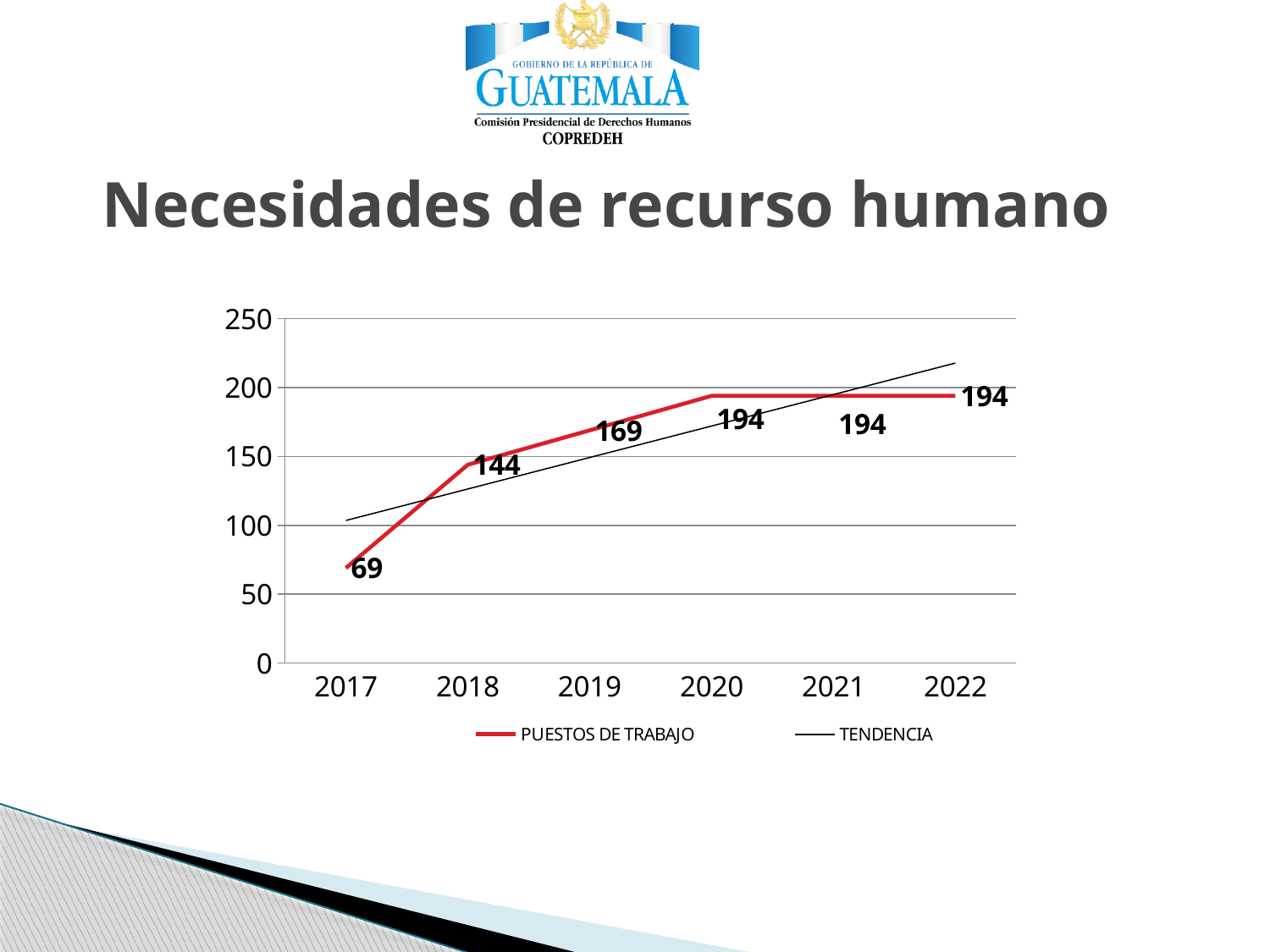
What is the value of PUESTOS DE TRABAJO for 2019? 169 Which is larger, the PUESTOS DE TRABAJO value for 2019 or for 2018? 2019 What kind of chart is shown on the slide? line chart How many years are shown on the x axis? 6 What is the value of PUESTOS DE TRABAJO for 2022? 194 What is the value of PUESTOS DE TRABAJO for 2018? 144 How many series does the legend list? 2 Which year has the lowest value for PUESTOS DE TRABAJO? 2017 What is the difference between the PUESTOS DE TRABAJO values for 2020 and 2019? 25 What is the difference between the PUESTOS DE TRABAJO values for 2018 and 2017? 75 What is the value of PUESTOS DE TRABAJO for 2017? 69 Is the PUESTOS DE TRABAJO value for 2017 greater or less than 100? less